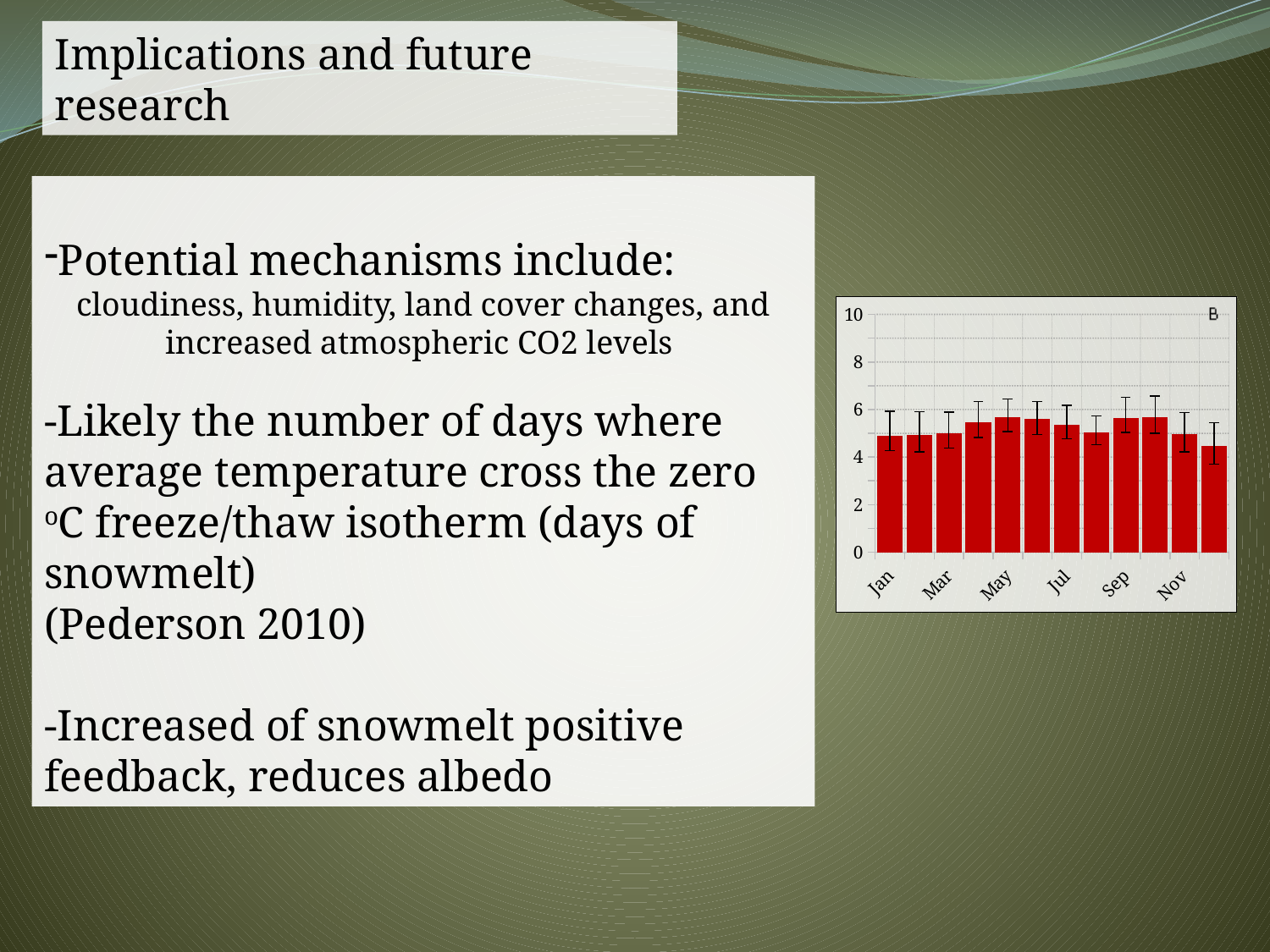
Is the value for Jul greater or less than 2? greater How many bars are plotted in the chart? 12 What is the highest value shown on the chart's vertical axis? 10 Is the value for Nov greater or less than 8? less What kind of chart is shown on the slide? bar chart Is the value for Sep greater or less than 4? greater How many month labels are printed along the x axis of the chart? 6 What letter is printed in the top right corner of the chart? B